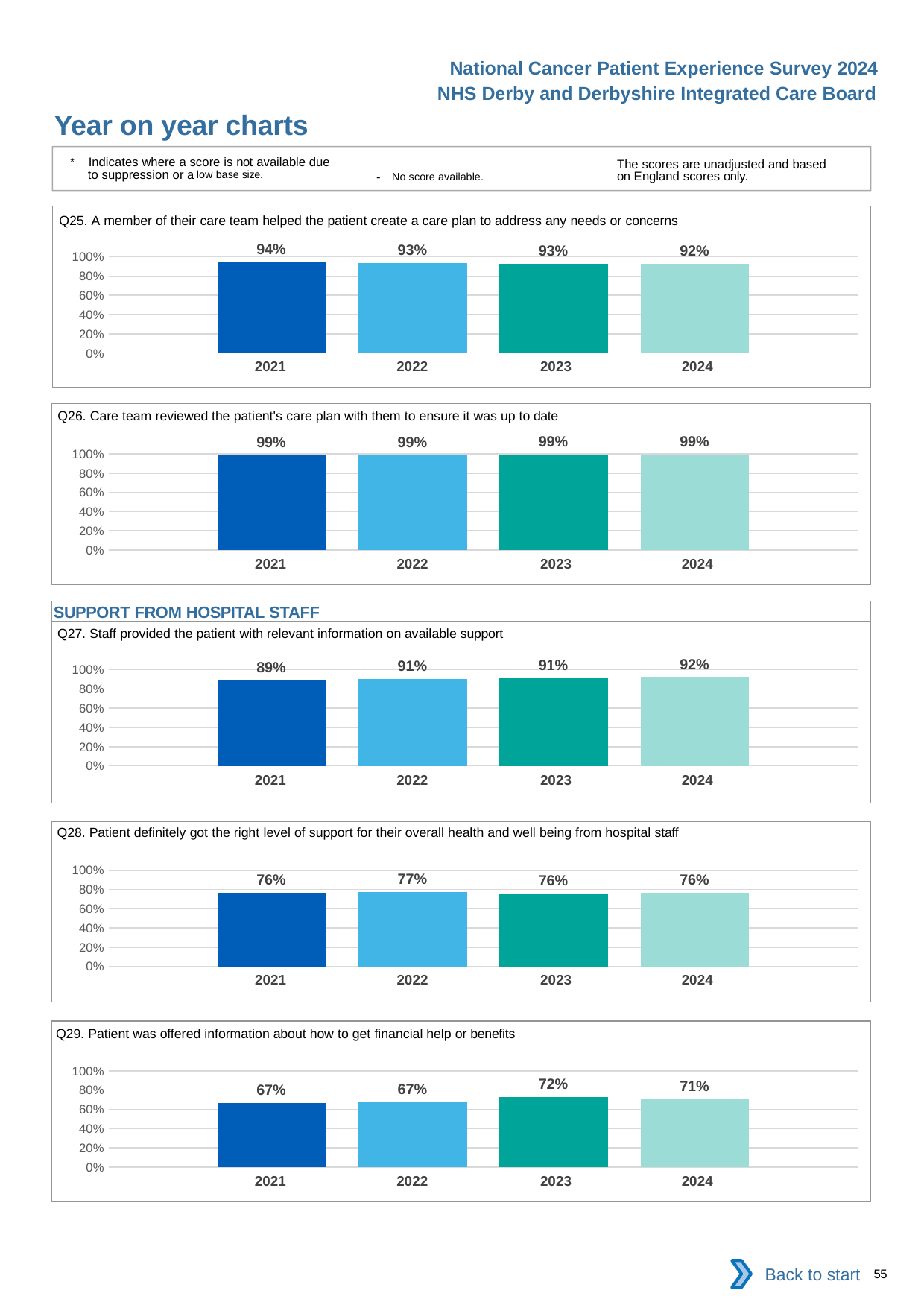
In the Q27 chart, what is the difference between the 2024 value and the 2021 value? 3 percentage points How many years are shown on the x axis of the Q25 chart? 4 In the Q29 chart, which is larger, the value for 2022 or the value for 2024? 2024 What type of chart is the Q29 chart? Bar chart In the Q28 chart, what is the value for 2022? 77% In the Q27 chart, which year has the highest value? 2024 In the Q25 chart, what is the value for 2021? 94% In the Q29 chart, which year has the highest value? 2023 In the Q25 chart, which year has the lowest value? 2024 In the Q26 chart, what is the value for 2024? 99% In the Q28 chart, is the value for 2021 greater or less than 80%? less In the Q29 chart, what is the difference between the 2023 value and the 2021 value? 5 percentage points